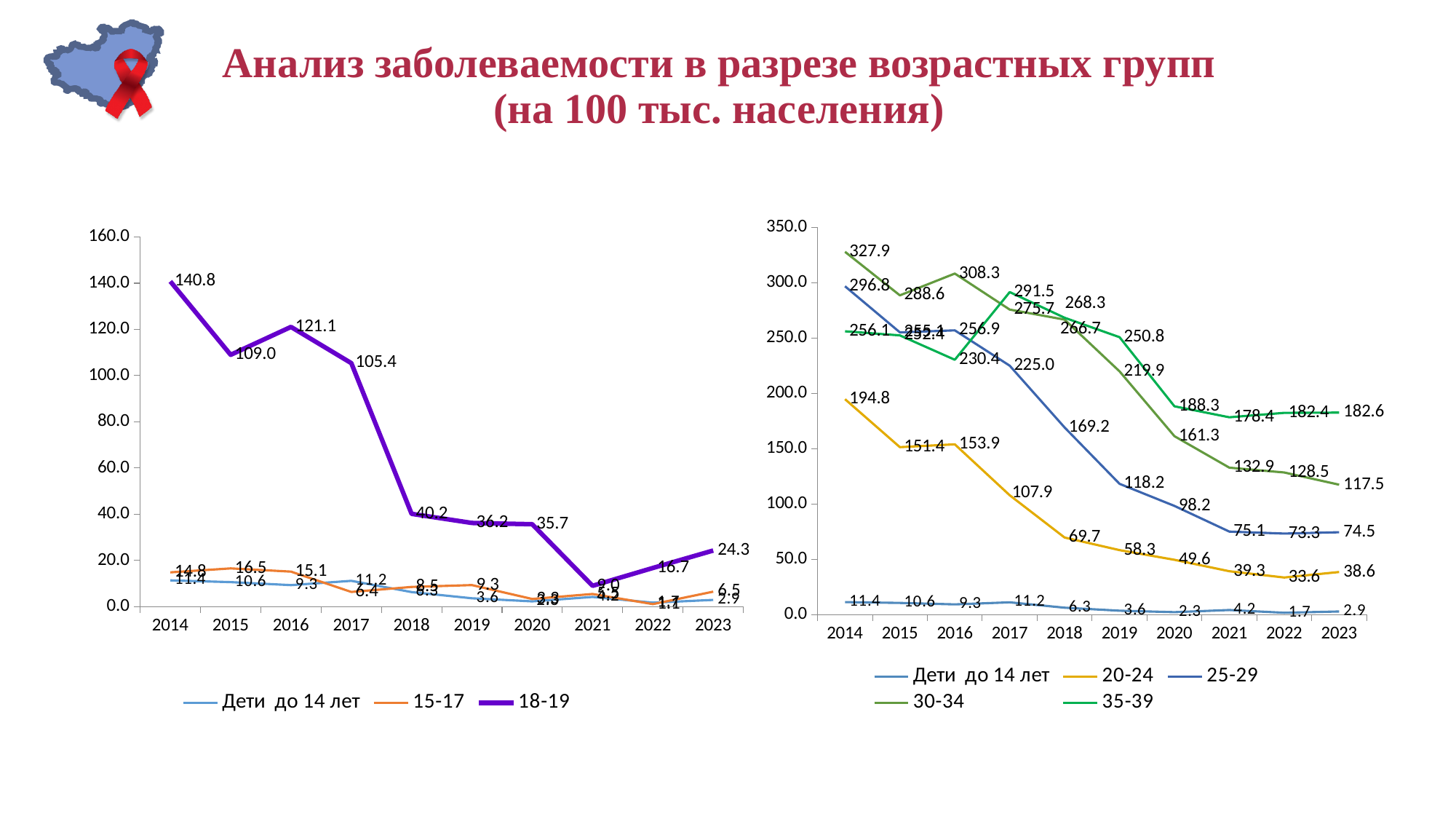
On the right chart, is the value for the 25-29 age group in 2018 greater or less than 150? greater On the left chart, what is the value for the 18-19 age group in 2014? 140.8 How many series does the legend of the right chart list? 5 On the left chart, what is the value for the 18-19 age group in 2016? 121.1 On the right chart, what is the value for the 30-34 age group in 2014? 327.9 On the left chart, what is the difference between the 18-19 values in 2014 and 2023? 116.5 On the right chart, what is the value for the 20-24 age group in 2023? 38.6 On the right chart, in which year does the 30-34 series reach its highest value? 2014 On the right chart, which series has the larger value in 2023: 35-39 or 30-34? 35-39 What kind of chart is the left chart? line chart How many years are shown on the x axis of the left chart? 10 On the right chart, in which year does the 'Дети до 14 лет' series reach its lowest value? 2022